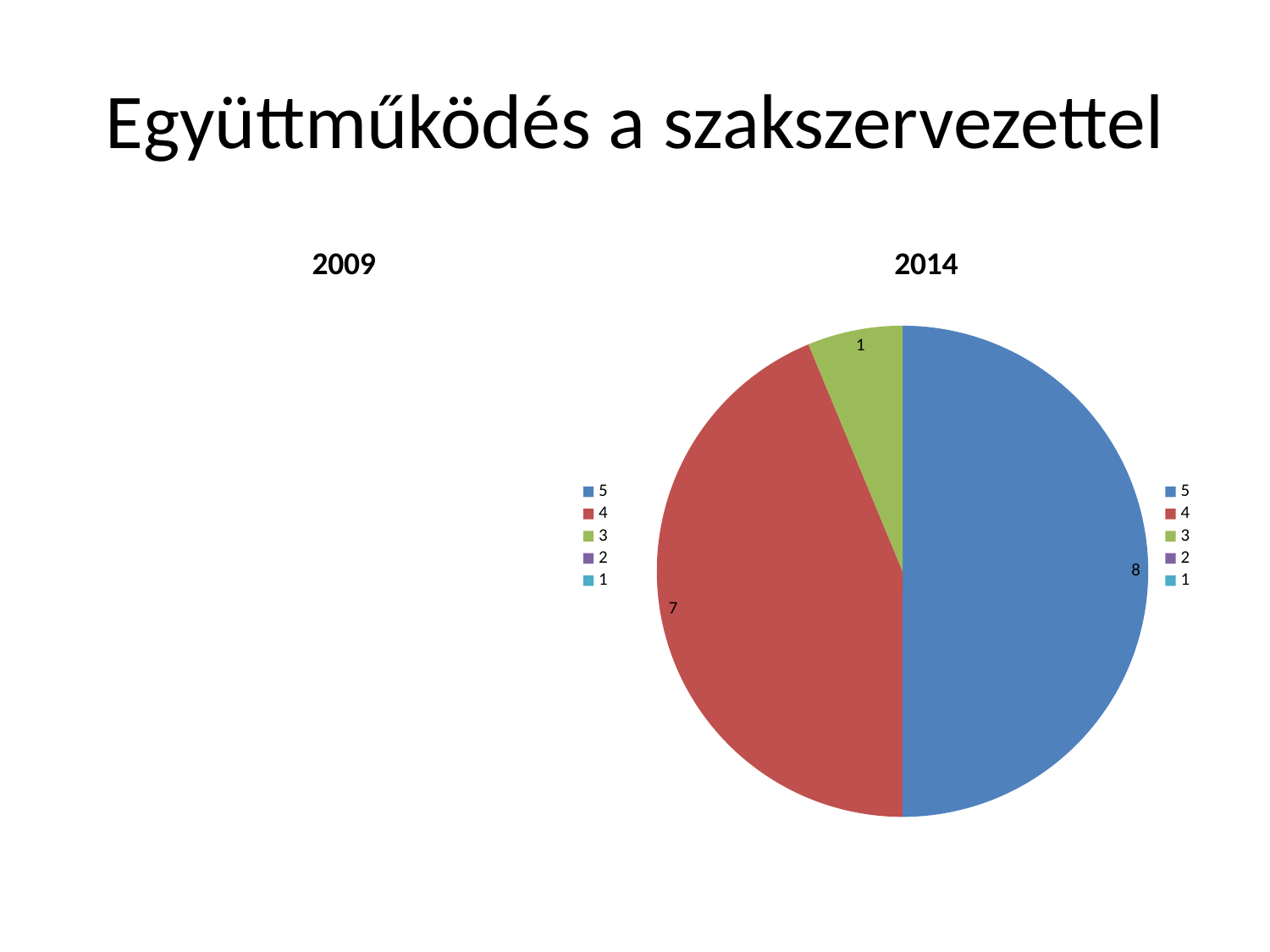
In the 2014 pie chart, what is the difference between the values for category 5 and category 4? 1 In the 2014 pie chart, what is the value of the slice for category 3? 1 In the 2014 pie chart, which category has the largest slice? 5 In the 2014 pie chart, what is the value of the slice for category 5? 8 In the 2014 pie chart, what share of the pie does the slice for category 5 represent? 50% In the 2014 pie chart, what is the total of the three labelled slice values? 16 In the 2014 pie chart, which is larger, the slice for category 4 or the slice for category 3? 4 How many entries does the legend of the 2014 pie chart list? 5 In the 2014 pie chart, which of the labelled slices is the smallest? 3 In the 2014 pie chart, what is the value of the slice for category 4? 7 What kind of chart is the 2014 chart on the right? pie chart In the 2014 pie chart, what is the difference between the values for category 5 and category 3? 7